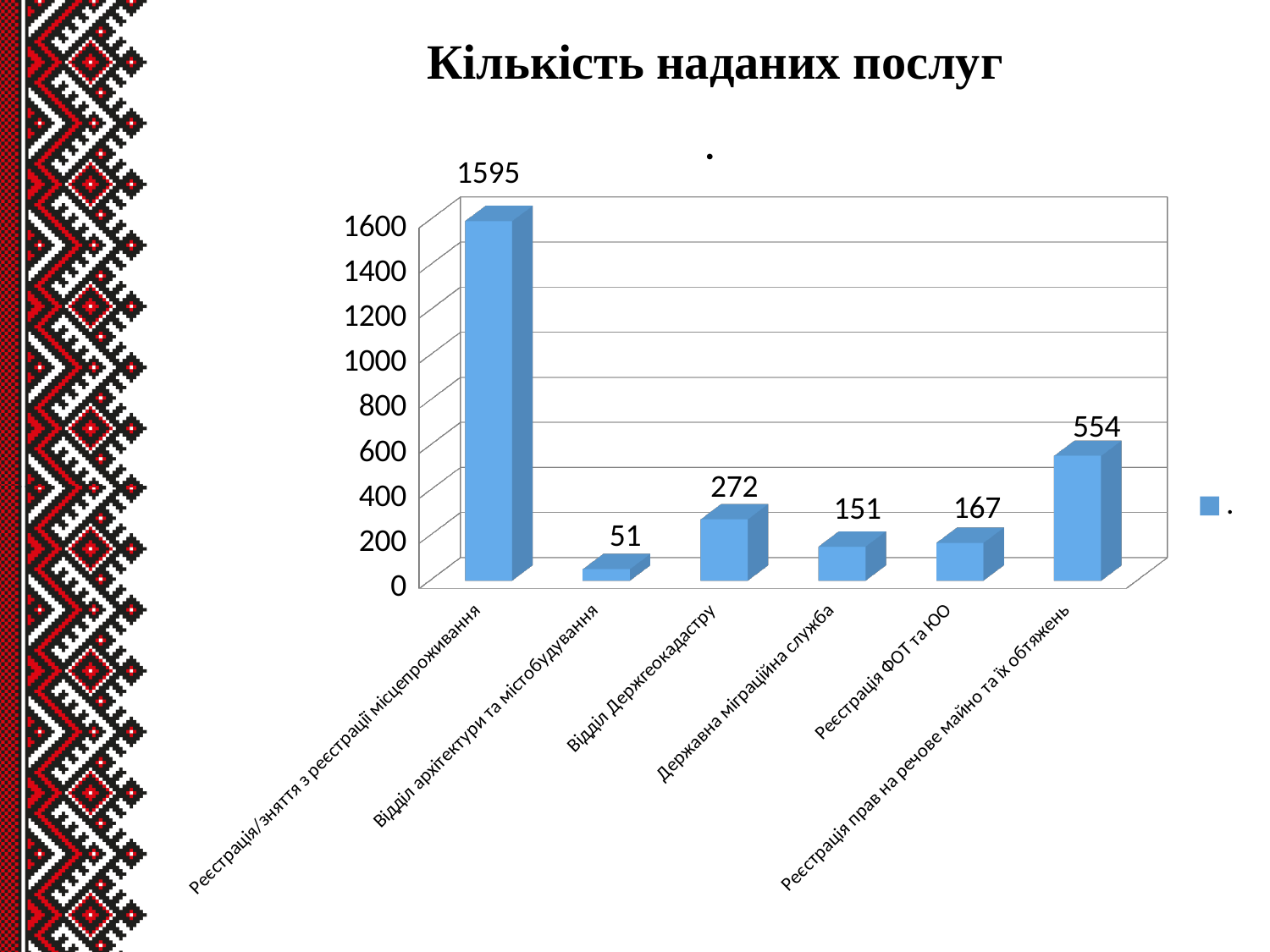
What is the value for Реєстрація прав на речове майно та їх обтяжень? 554 What is the title of the slide? Кількість наданих послуг What is the value for Відділ Держгеокадастру? 272 What kind of chart is shown on the slide? bar chart What is the difference between the values for Реєстрація/зняття з реєстрації місцепроживання and Реєстрація прав на речове майно та їх обтяжень? 1041 Is the value for Реєстрація прав на речове майно та їх обтяжень greater or less than 400? greater Which category has the lowest value? Відділ архітектури та містобудування Which category has the highest value? Реєстрація/зняття з реєстрації місцепроживання What is the value for Державна міграційна служба? 151 What is the difference between the values for Реєстрація ФОТ та ЮО and Державна міграційна служба? 16 Which is larger, the value for Відділ Держгеокадастру or the value for Реєстрація ФОТ та ЮО? Відділ Держгеокадастру How many categories are shown on the chart? 6